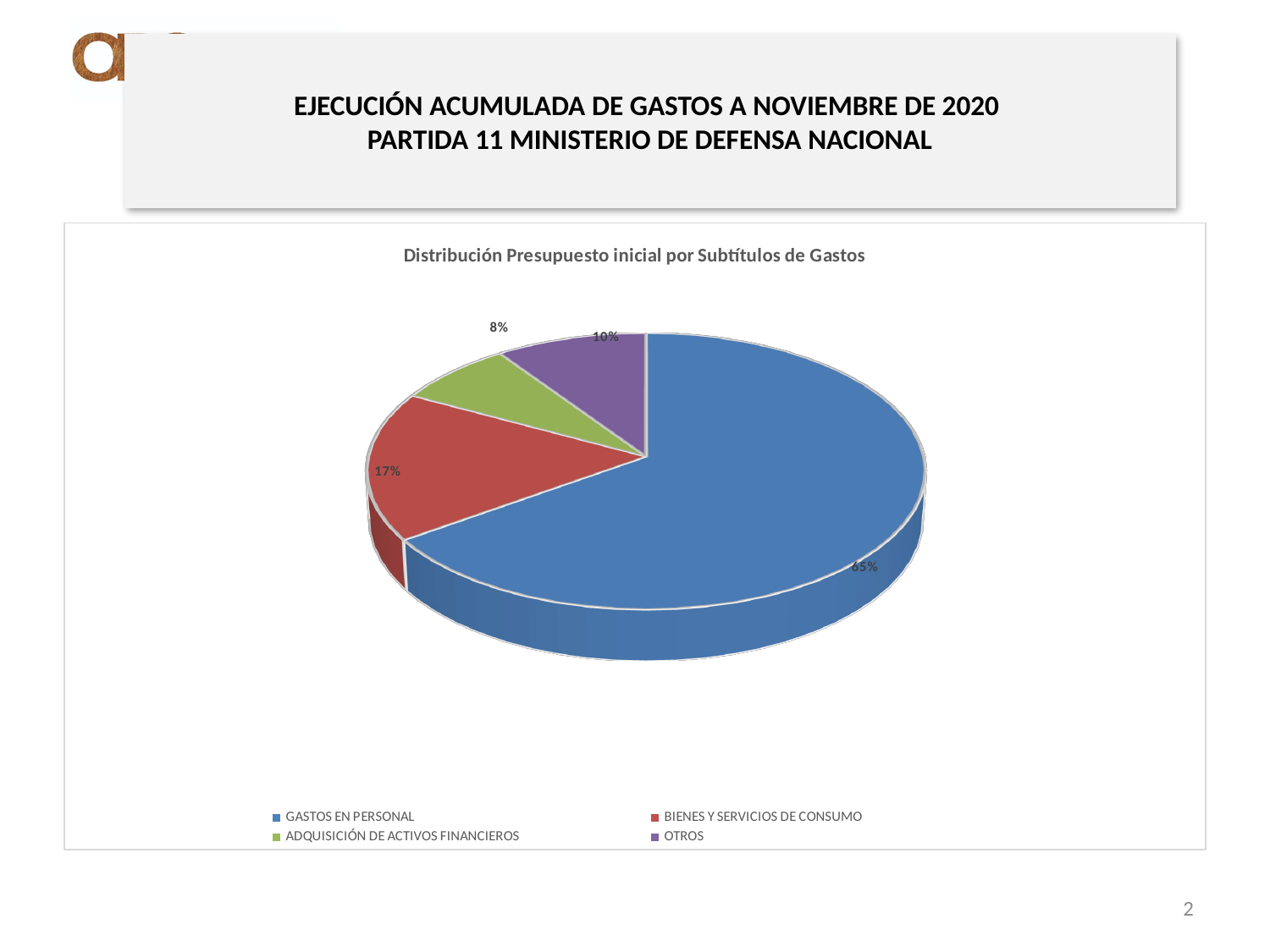
Which colour represents BIENES Y SERVICIOS DE CONSUMO in the pie chart? Red What kind of chart is shown on the slide? Pie chart What share of the pie does BIENES Y SERVICIOS DE CONSUMO represent? 17% Which category has the smallest share of the pie? ADQUISICIÓN DE ACTIVOS FINANCIEROS How many slices does the pie chart have? 4 What is the title of the chart? Distribución Presupuesto inicial por Subtítulos de Gastos What is the difference in percentage points between GASTOS EN PERSONAL and BIENES Y SERVICIOS DE CONSUMO? 48 Which category has the largest share of the pie? GASTOS EN PERSONAL What share of the pie does ADQUISICIÓN DE ACTIVOS FINANCIEROS represent? 8% What share of the pie does OTROS represent? 10% Which is larger, the share for OTROS or the share for ADQUISICIÓN DE ACTIVOS FINANCIEROS? OTROS